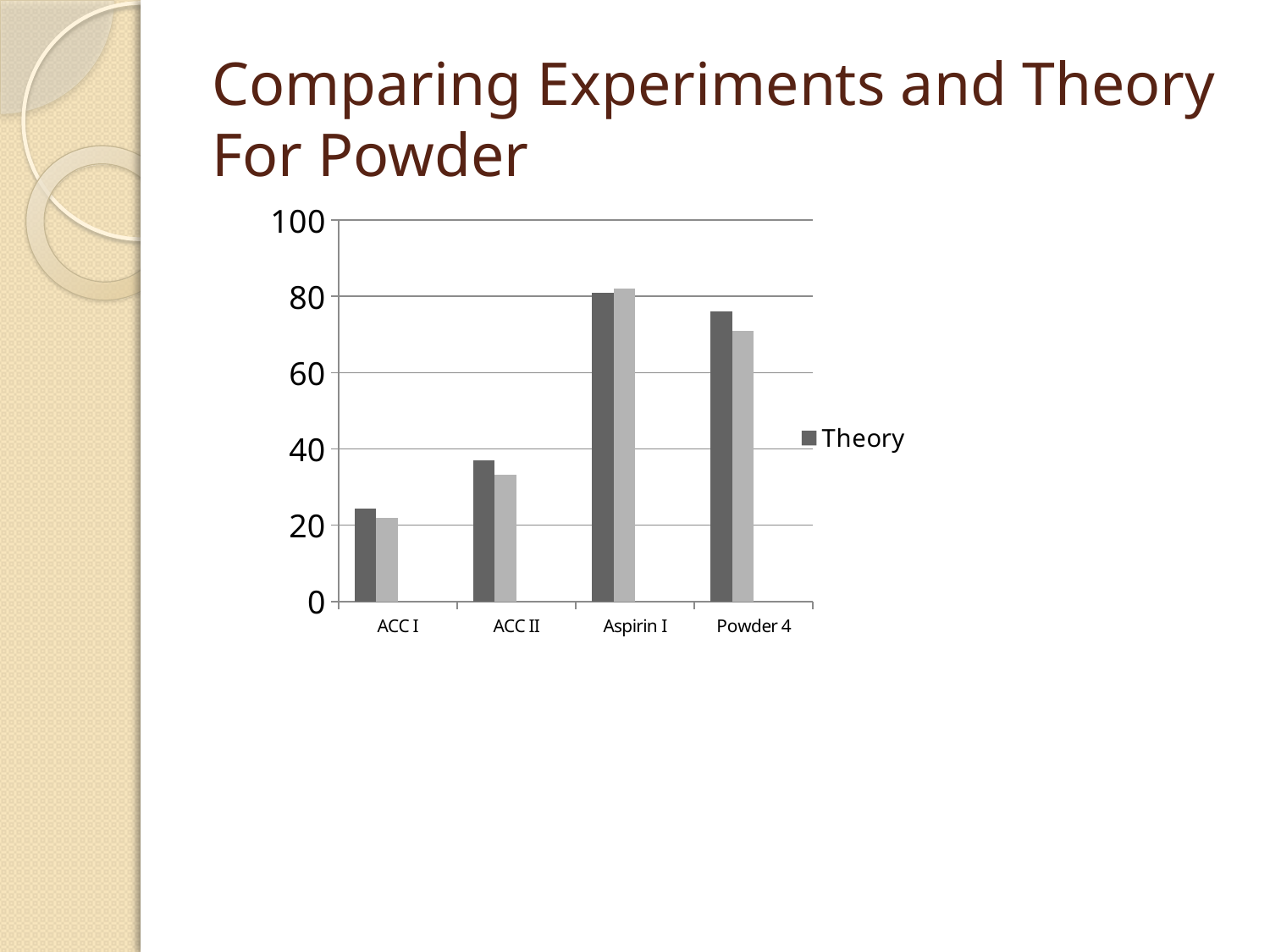
What is the name of the series listed in the chart's legend? Theory Which category has the highest Theory value? Aspirin I Which has the larger Theory value, ACC I or ACC II? ACC II Which category has the lowest Theory value? ACC I Is the Theory value for Powder 4 greater or less than 60? greater Is the Theory value for ACC II greater or less than 20? greater Is the Theory value for Aspirin I greater or less than 60? greater What kind of chart is shown on the slide? bar chart How many series does the chart's legend list? 1 Do the Theory values rise or fall from ACC I to Aspirin I along the x axis? rise How many categories are shown on the x axis of the chart? 4